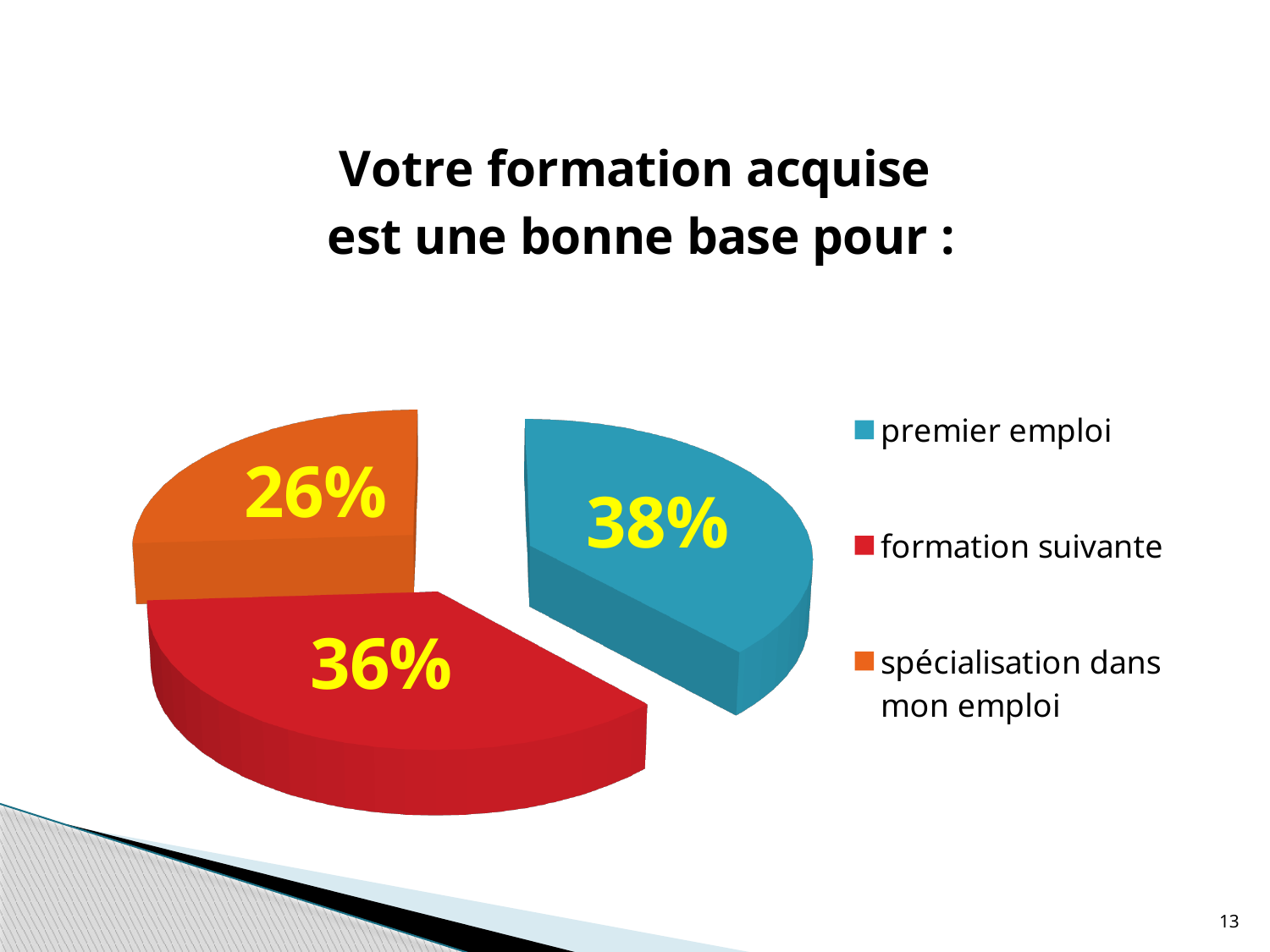
What is the difference in percentage points between "formation suivante" and "spécialisation dans mon emploi"? 10 What share of the pie does "formation suivante" represent? 36% What colour is the slice for "formation suivante"? red What share of the pie does "premier emploi" represent? 38% What kind of chart is shown on the slide? pie chart What is the difference in percentage points between "premier emploi" and "spécialisation dans mon emploi"? 12 What is the title of the chart? Votre formation acquise est une bonne base pour : Which is larger, the slice for "formation suivante" or the slice for "spécialisation dans mon emploi"? formation suivante How many slices does the pie chart have? 3 What share of the pie does "spécialisation dans mon emploi" represent? 26% Which category has the largest slice of the pie? premier emploi Which category has the smallest slice of the pie? spécialisation dans mon emploi